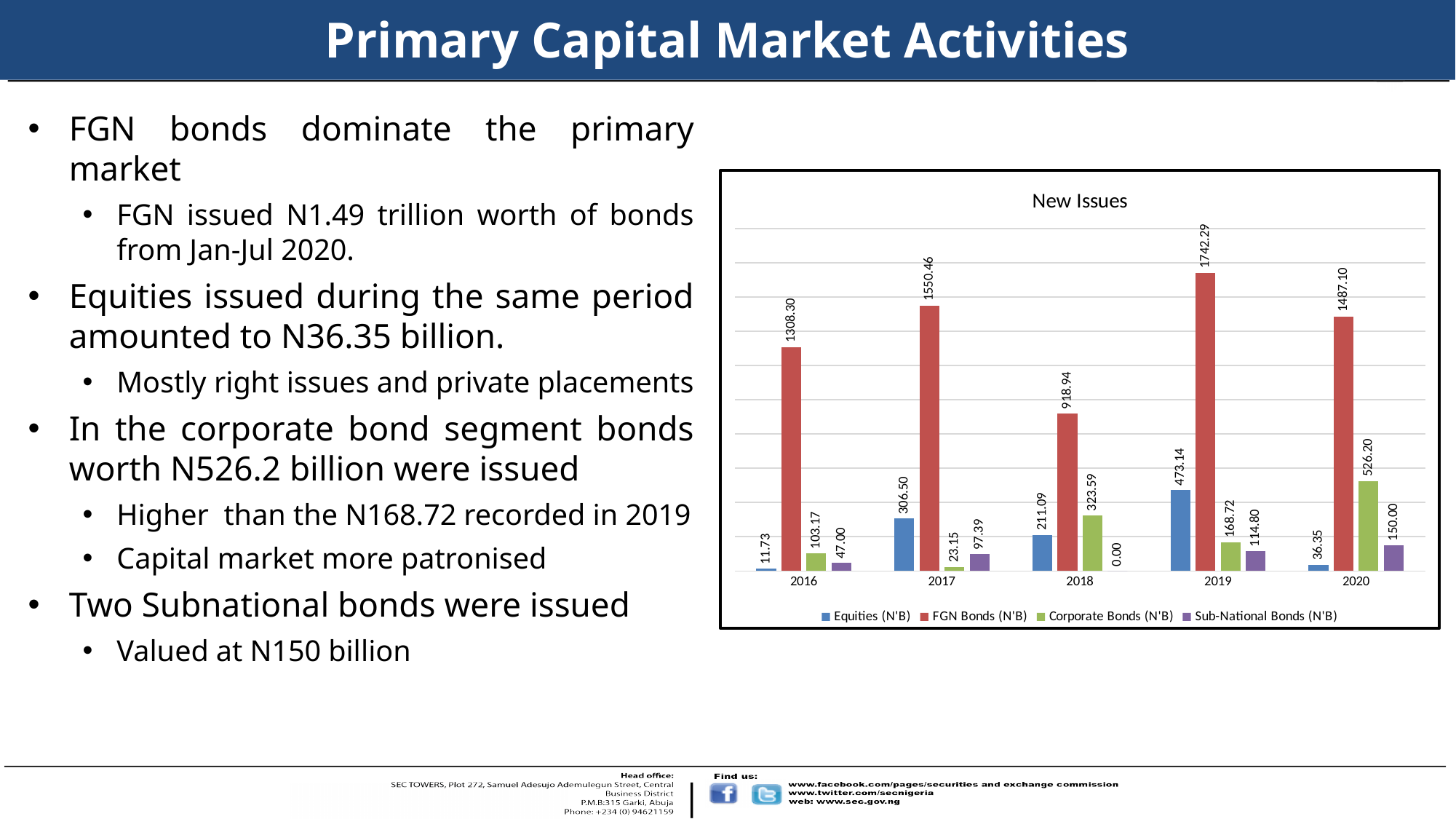
What is the difference between Corporate Bonds (N'B) in 2020 and in 2019 in the New Issues chart? 357.48 What is the value of Equities (N'B) in 2016 in the New Issues chart? 11.73 In which year were FGN Bonds (N'B) highest in the New Issues chart? 2019 How many series does the legend of the New Issues chart list? 4 What is the value of Sub-National Bonds (N'B) in 2018 in the New Issues chart? 0.00 What is the value of Corporate Bonds (N'B) in 2020 in the New Issues chart? 526.20 Which colour represents FGN Bonds (N'B) in the New Issues chart? Red What is the value of FGN Bonds (N'B) in 2019 in the New Issues chart? 1742.29 In which year were Equities (N'B) lowest in the New Issues chart? 2016 How many years are shown on the x axis of the New Issues chart? 5 Which is larger in the New Issues chart: Equities (N'B) in 2017 or Equities (N'B) in 2018? Equities (N'B) in 2017 What type of chart is the New Issues chart? Bar chart